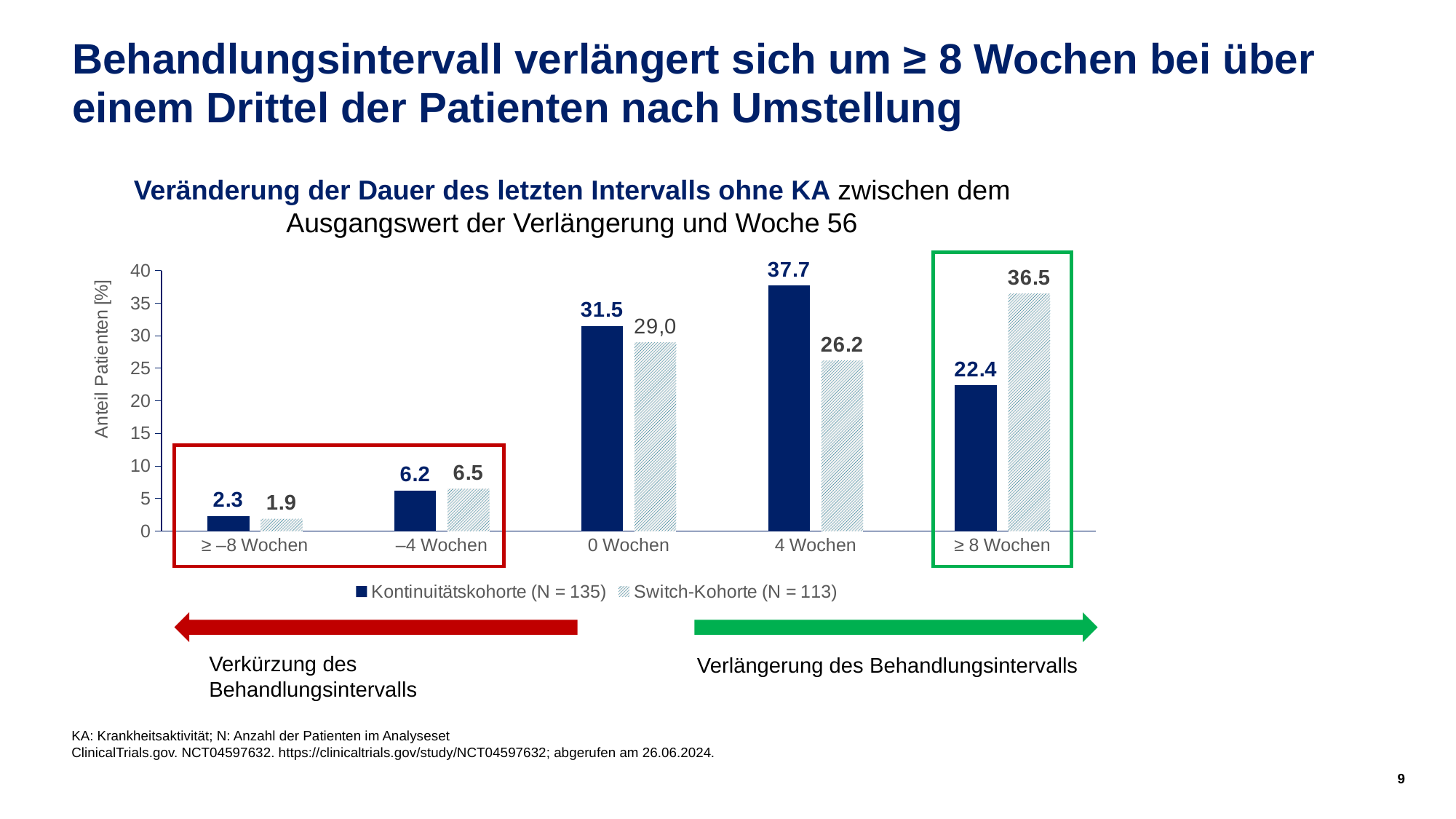
Is the value for the Kontinuitätskohorte at ≥ 8 Wochen greater or less than 25? less Which category has the highest value for the Kontinuitätskohorte? 4 Wochen What is the value for the Kontinuitätskohorte at 4 Wochen? 37.7 How many categories are shown on the x axis? 5 What is the difference between the Switch-Kohorte and the Kontinuitätskohorte at ≥ 8 Wochen? 14.1 What is the value for the Switch-Kohorte at ≥ 8 Wochen? 36.5 At 4 Wochen, which series has the larger value, Kontinuitätskohorte or Switch-Kohorte? Kontinuitätskohorte What is the y-axis label of the chart? Anteil Patienten [%] How many series does the legend list? 2 Which category has the lowest value for the Switch-Kohorte? ≥ –8 Wochen What kind of chart is shown on the slide? bar chart What is the value for the Switch-Kohorte at 0 Wochen? 29,0